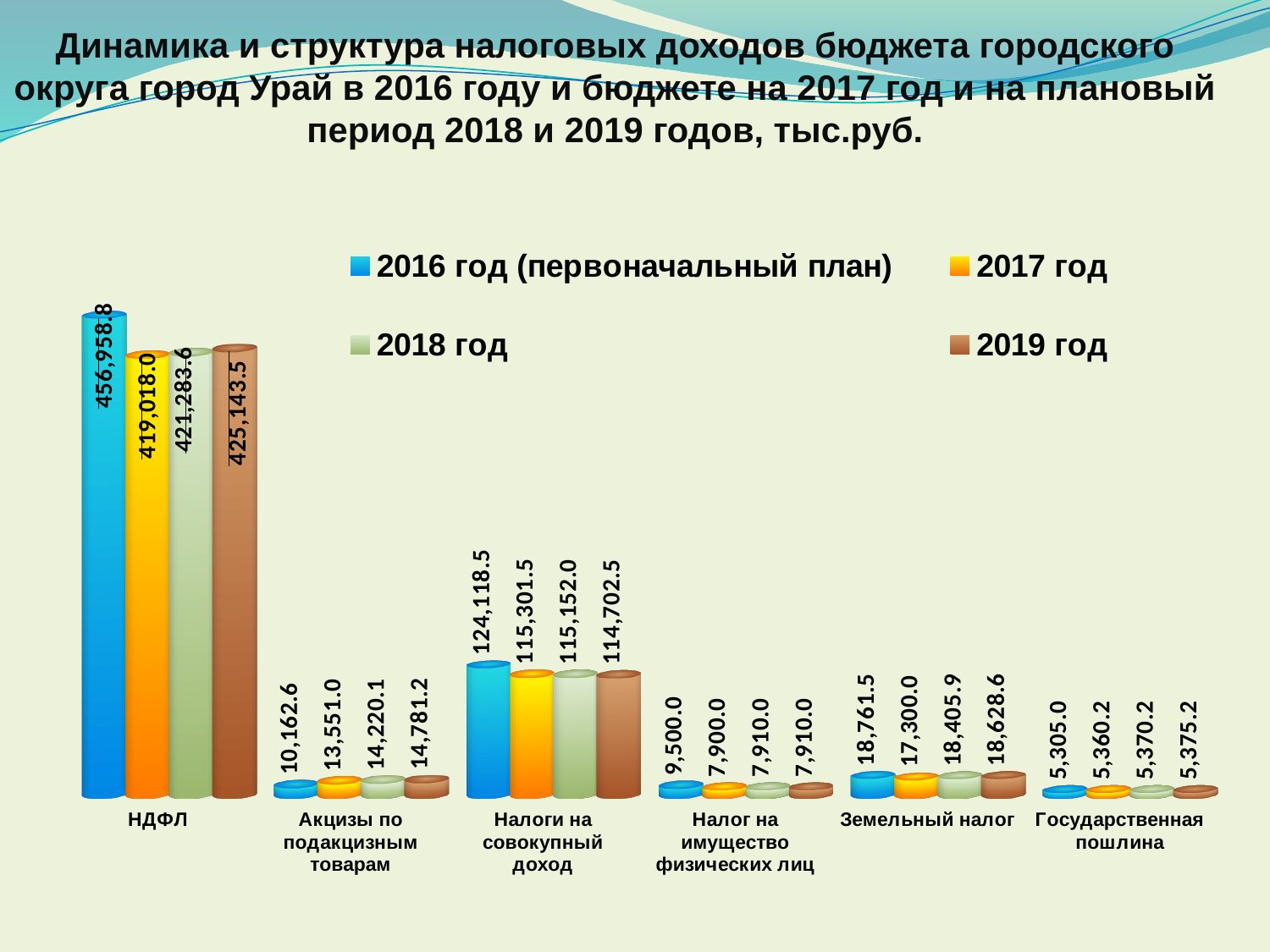
What is the difference between the 2019 год and 2016 год (первоначальный план) values for Акцизы по подакцизным товарам? 4,618.6 How many series does the legend list? 4 What is the value for Налог на имущество физических лиц in the 2017 год series? 7,900.0 Which category has the highest value in the 2018 год series? НДФЛ Do the values for Государственная пошлина rise or fall from 2016 год to 2019 год? Rise What is the value for Земельный налог in the 2019 год series? 18,628.6 What kind of chart is shown on the slide? Bar chart How many categories are shown on the x axis? 6 Which category has the lowest value in the 2016 год (первоначальный план) series? Государственная пошлина What is the value for НДФЛ in the 2016 год (первоначальный план) series? 456,958.8 Which is larger for Налоги на совокупный доход: the 2017 год value or the 2019 год value? 2017 год What is the difference between the 2016 год (первоначальный план) and 2017 год values for НДФЛ? 37,940.8